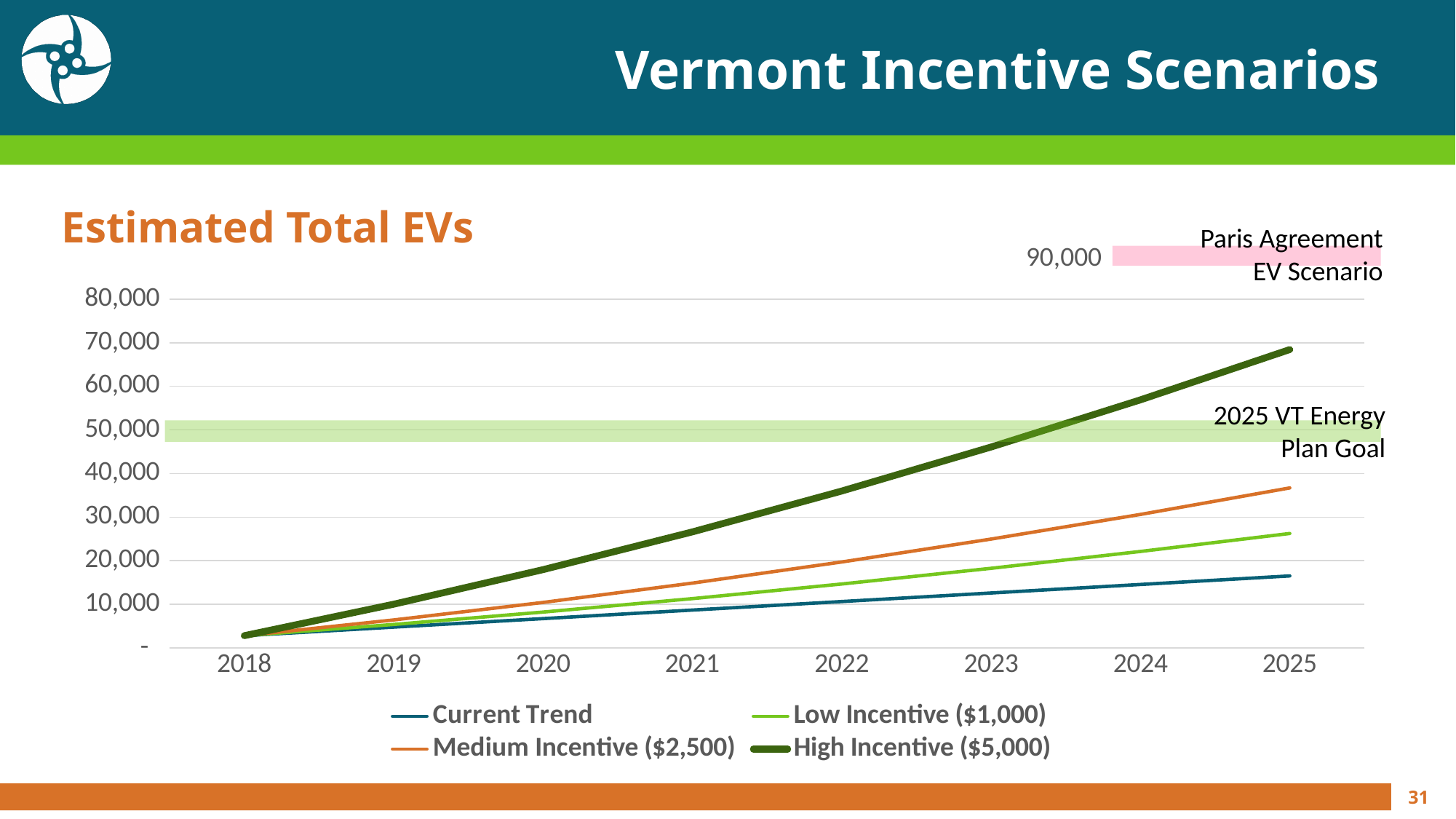
How many years are shown along the x axis? 8 What value is labelled for the Paris Agreement EV Scenario band? 90,000 Is the value for High Incentive ($5,000) in 2025 greater or less than 60,000? greater What is the title of the chart? Estimated Total EVs Is the value for Medium Incentive ($2,500) in 2025 greater or less than 40,000? less What kind of chart is shown on the slide? line chart Which series has the lowest value in 2025? Current Trend Do the values for High Incentive ($5,000) rise or fall from 2018 to 2025? rise Is the value for Current Trend in 2025 greater or less than 20,000? less Which series has the highest value in 2025? High Incentive ($5,000) How many series does the legend list? 4 In 2025, which is larger: Medium Incentive ($2,500) or Low Incentive ($1,000)? Medium Incentive ($2,500)